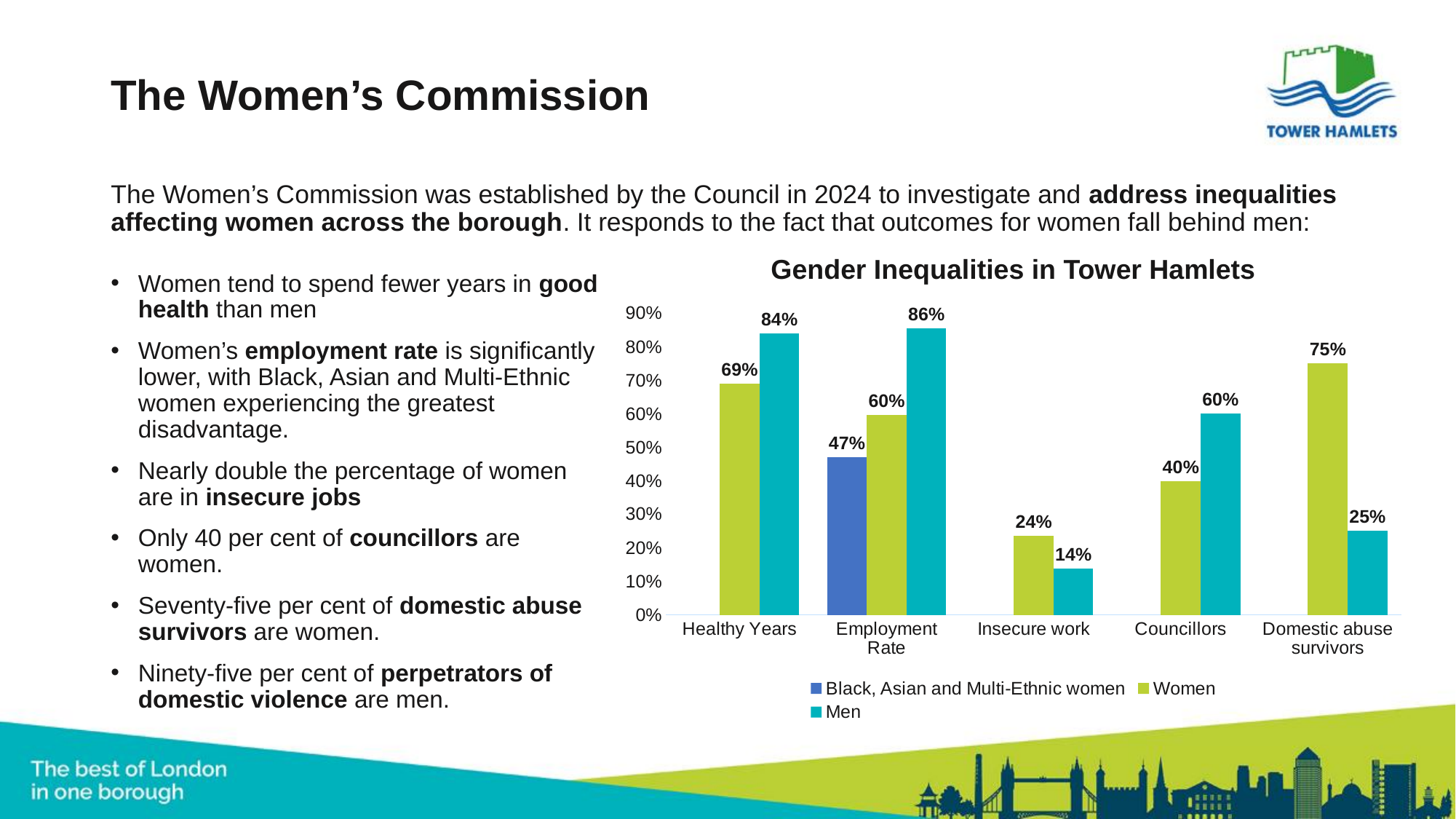
How many categories are shown on the x axis? 5 What is the difference between the Men and Women values in the Councillors category? 20% What is the value for Black, Asian and Multi-Ethnic women in the Employment Rate category? 47% Which category has the highest value for the Men series? Employment Rate Which is larger in the Domestic abuse survivors category, the Women value or the Men value? Women What kind of chart is shown on the slide? Bar chart How many series does the legend list? 3 What is the value for Men in the Employment Rate category? 86% What is the title of the chart? Gender Inequalities in Tower Hamlets What is the value for Men in the Insecure work category? 14% What is the value for Women in the Healthy Years category? 69% Which category has the lowest value for the Women series? Insecure work